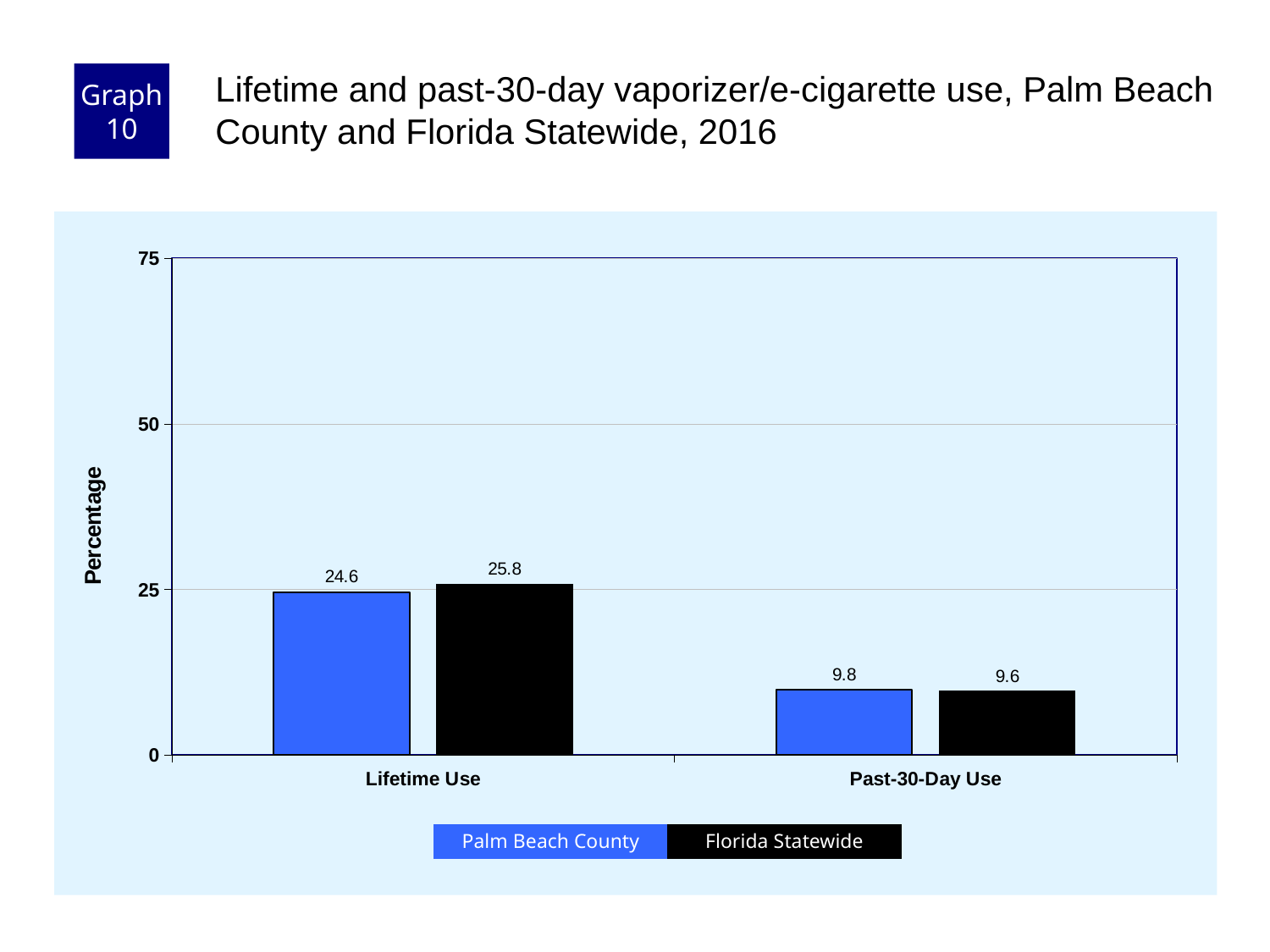
What is the Palm Beach County value for Past-30-Day Use? 9.8 Which category has the lowest Palm Beach County value? Past-30-Day Use What kind of chart is shown on the slide? bar chart Which category has the highest Florida Statewide value? Lifetime Use How many categories are shown on the x axis? 2 What is the Florida Statewide value for Past-30-Day Use? 9.6 Is the Palm Beach County value for Lifetime Use greater or less than 50? less What is the Palm Beach County value for Lifetime Use? 24.6 What is the difference between the Palm Beach County and Florida Statewide values for Past-30-Day Use? 0.2 How many series does the legend list? 2 What is the difference between the Florida Statewide and Palm Beach County values for Lifetime Use? 1.2 What is the Florida Statewide value for Lifetime Use? 25.8